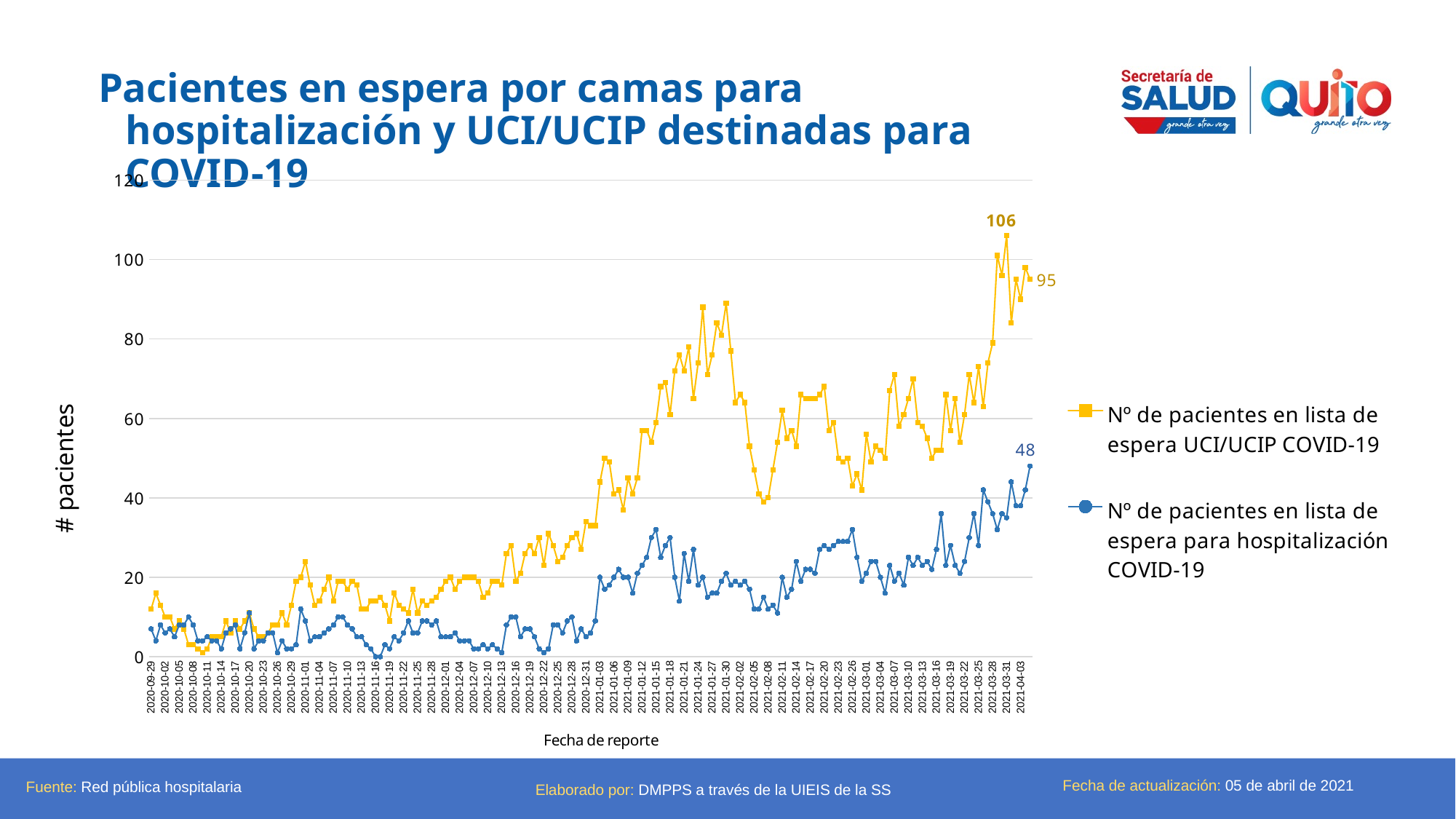
Overall, does the UCI/UCIP series rise or fall from 2020-09-29 to 2021-04-03? Rise What is the difference between the final labelled values of the UCI/UCIP series (95) and the hospitalización series (48)? 47 What kind of chart is shown on the slide? Line chart By how much does the peak of the UCI/UCIP series (106) exceed its final labelled value (95)? 11 What is the last labelled value of the 'Nº de pacientes en lista de espera para hospitalización COVID-19' series? 48 Is the highest value of the 'Nº de pacientes en lista de espera para hospitalización COVID-19' series greater or less than 60? less What is the highest value reached by the 'Nº de pacientes en lista de espera UCI/UCIP COVID-19' series? 106 At the end of the period, which series has the higher value: UCI/UCIP or hospitalización? UCI/UCIP What is the last labelled value of the 'Nº de pacientes en lista de espera UCI/UCIP COVID-19' series? 95 What is the title of the x axis? Fecha de reporte How many series does the legend list? 2 What is the title of the y axis? # pacientes